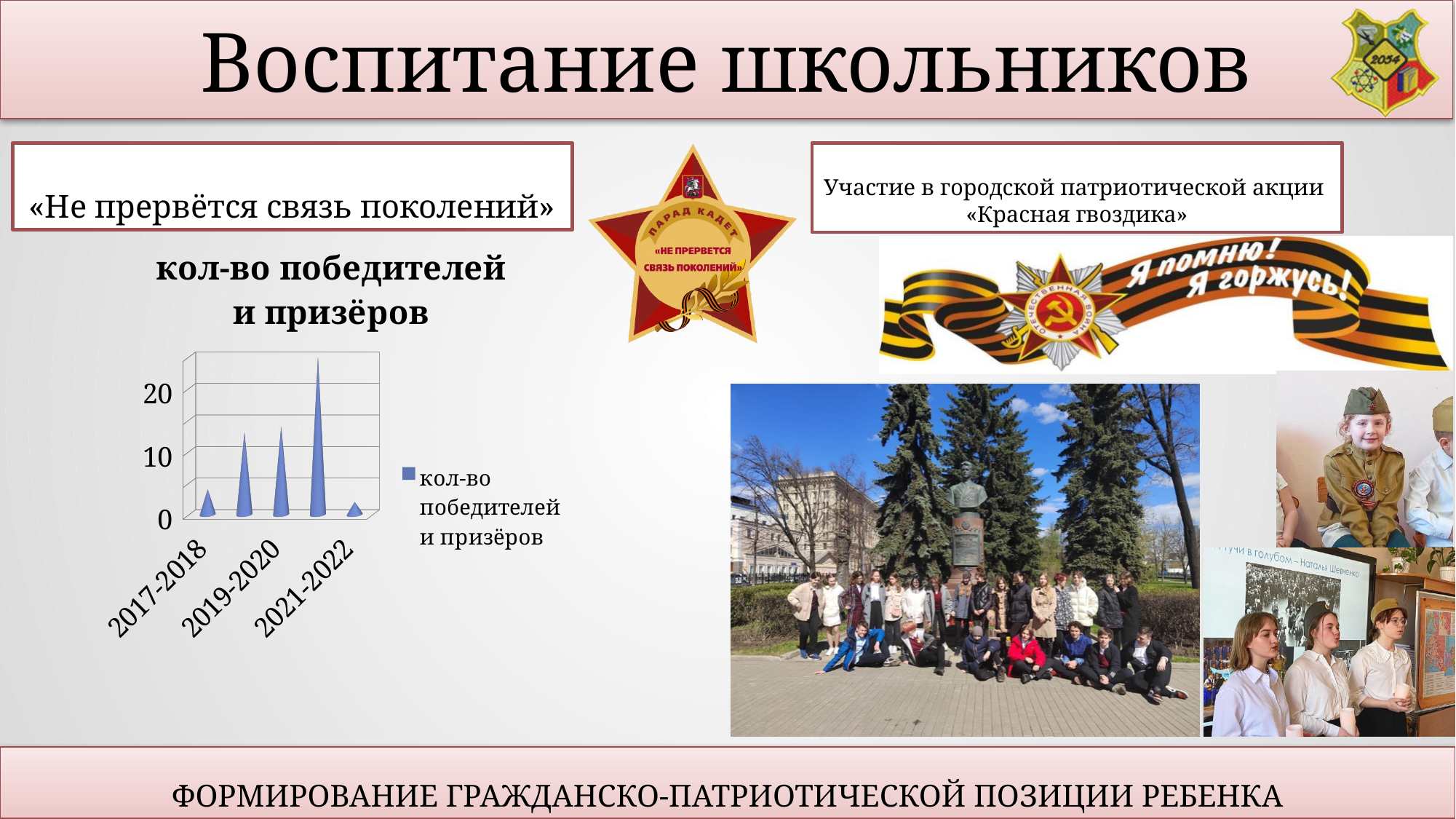
How many bars does the chart contain? 5 Is the value for 2021-2022 greater or less than 10? less What is the title of the chart? кол-во победителей и призёров Is the value for 2017-2018 greater or less than 10? less Which is larger, the value for 2017-2018 or the value for 2019-2020? 2019-2020 What is the highest tick value shown on the vertical axis of the chart? 20 How many series does the chart legend list? 1 What kind of chart is shown on the slide? bar chart Which is larger, the value for 2019-2020 or the value for 2021-2022? 2019-2020 What is the legend entry of the chart? кол-во победителей и призёров Is the value for 2019-2020 greater or less than 10? greater